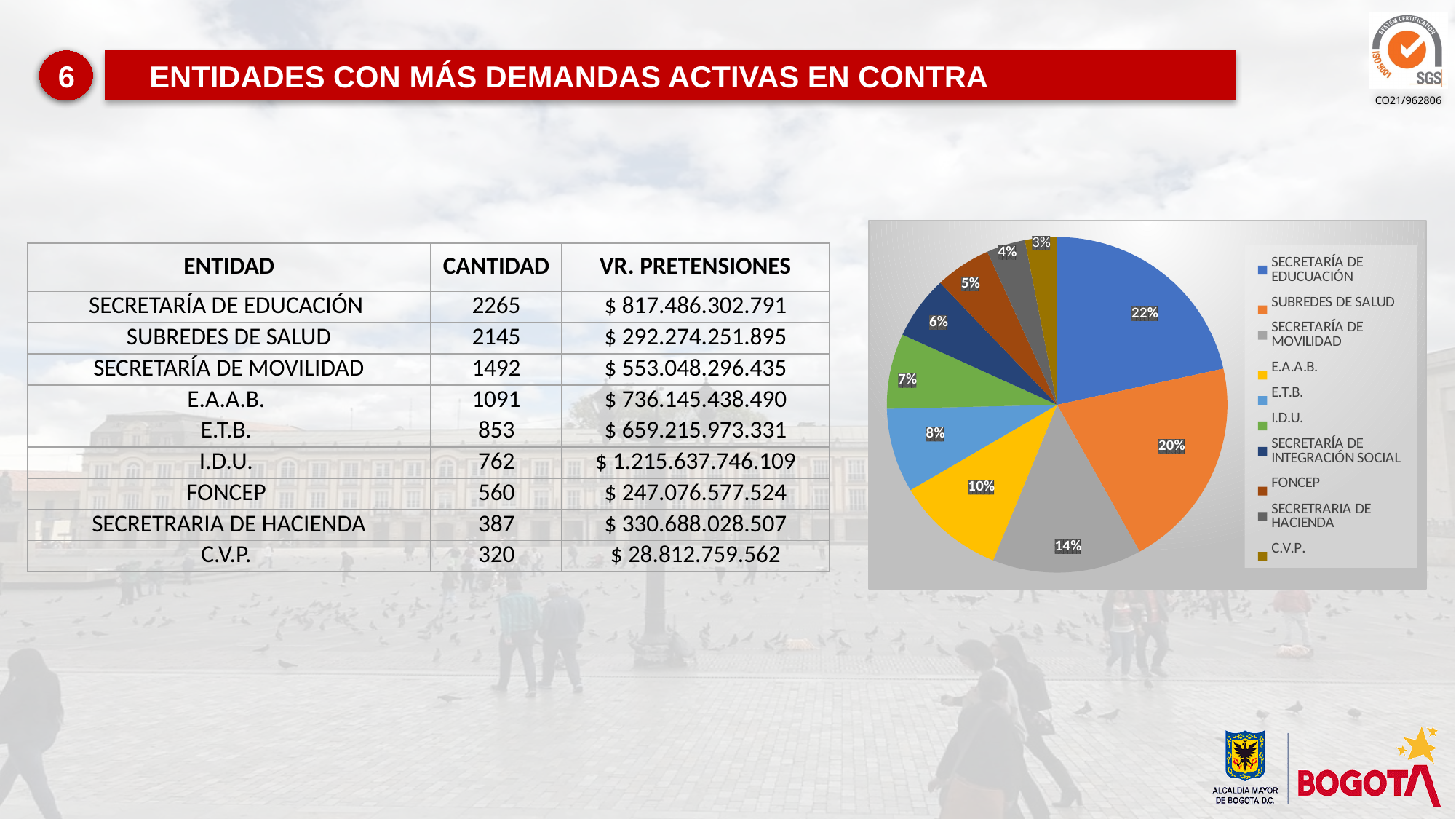
Which entity has the largest slice in the pie chart? SECRETARÍA DE EDUCACIÓN What kind of chart is shown on the slide? pie chart What share of the pie chart does SECRETARÍA DE EDUCACIÓN represent? 22% What colour is the SUBREDES DE SALUD slice in the pie chart? orange What share of the pie chart does SECRETARÍA DE MOVILIDAD represent? 14% What is the difference in percentage points between the SECRETARÍA DE EDUCACIÓN slice and the FONCEP slice in the pie chart? 17 How many slices does the pie chart have? 10 What share of the pie chart does E.T.B. represent? 8% Which entity has the smallest slice in the pie chart? C.V.P. In the pie chart, which slice is larger: E.A.A.B. or I.D.U.? E.A.A.B.